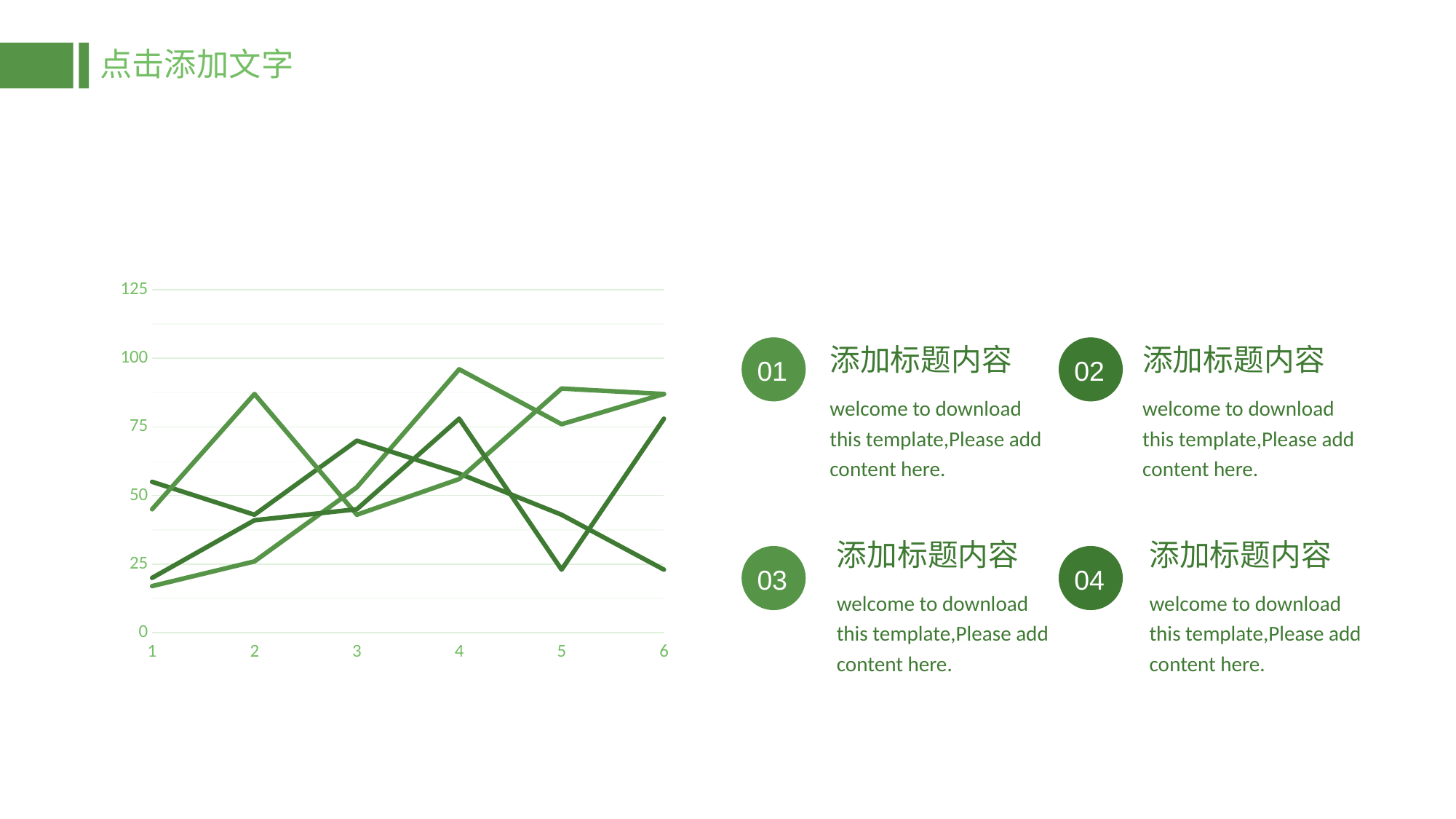
How many points are labelled along the x axis of the chart? 6 What kind of chart is shown on the slide? line chart Is the lowest point reached by any line on the chart greater or less than 25? less Does any line on the chart rise above 100? No What is the highest value labelled on the y axis of the chart? 125 What is the lowest value labelled on the y axis of the chart? 0 What is the first label on the x axis of the chart? 1 What is the last label on the x axis of the chart? 6 How many lines are plotted on the chart? 4 Is the highest point reached by any line on the chart greater or less than 100? less